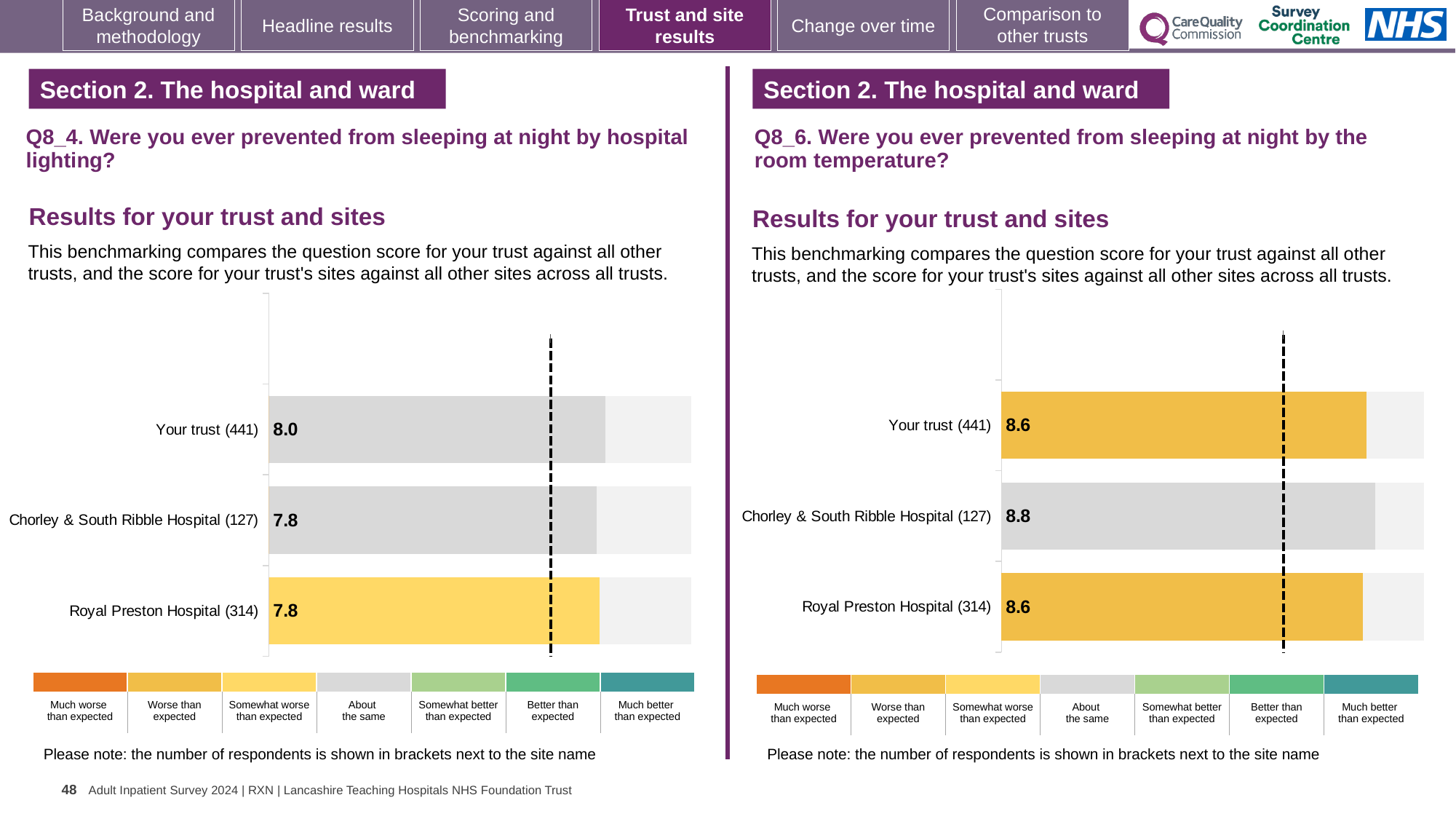
On the Q8_4 hospital lighting chart, which bar has the highest score? Your trust (441) On the Q8_4 hospital lighting chart, what is the difference between the scores for Your trust and Chorley & South Ribble Hospital? 0.2 On the Q8_6 room temperature chart, which is larger: the score for Chorley & South Ribble Hospital or the score for Your trust? Chorley & South Ribble Hospital What kind of chart is used for the Q8_6 room temperature results? Bar chart On the Q8_4 hospital lighting chart, what is the score for Your trust (441)? 8.0 On the Q8_6 room temperature chart, what is the score for Your trust (441)? 8.6 On the Q8_6 room temperature chart, what is the difference between the scores for Chorley & South Ribble Hospital and Royal Preston Hospital? 0.2 On the Q8_4 hospital lighting chart, which bar is coloured yellow? Royal Preston Hospital (314) How many bars are shown on the Q8_4 hospital lighting chart? 3 On the Q8_4 hospital lighting chart, what is the score for Royal Preston Hospital (314)? 7.8 On the Q8_6 room temperature chart, which bar has the highest score? Chorley & South Ribble Hospital (127) On the Q8_6 room temperature chart, what is the score for Chorley & South Ribble Hospital (127)? 8.8